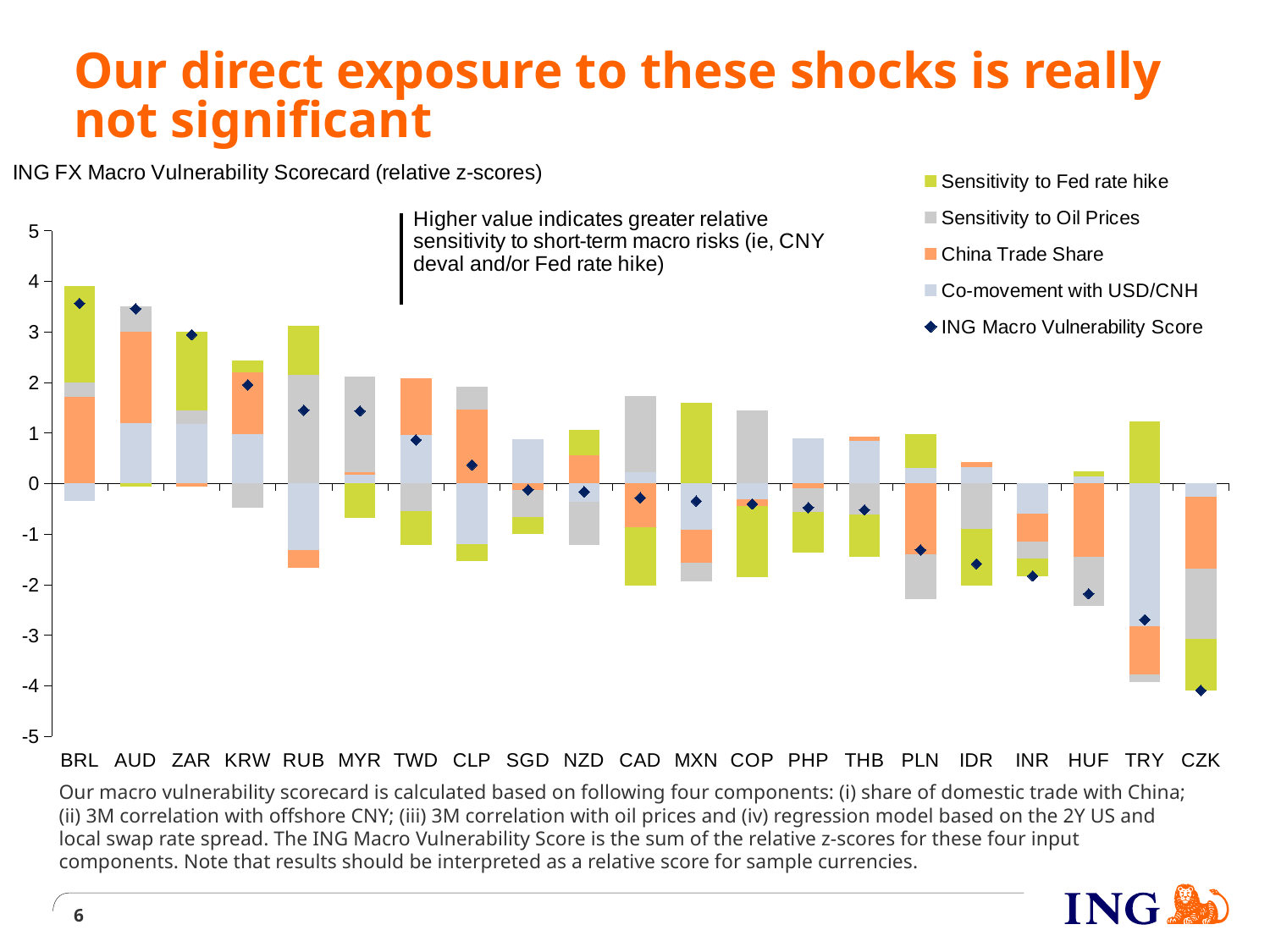
Which has the larger ING Macro Vulnerability Score, PLN or CZK? PLN Is the ING Macro Vulnerability Score for BRL greater or less than 3? greater How many currencies are shown along the x axis of the chart? 21 What is the title of the chart? ING FX Macro Vulnerability Scorecard (relative z-scores) How many series does the chart's legend list? 5 Do the ING Macro Vulnerability Scores generally rise or fall moving from left to right along the x axis? fall Is the ING Macro Vulnerability Score for CZK greater or less than -3? less Which has the larger ING Macro Vulnerability Score, BRL or KRW? BRL Is the ING Macro Vulnerability Score for KRW greater or less than 1? greater What kind of chart is shown on the slide? Stacked bar chart with a marker series Which currency has the lowest ING Macro Vulnerability Score? CZK